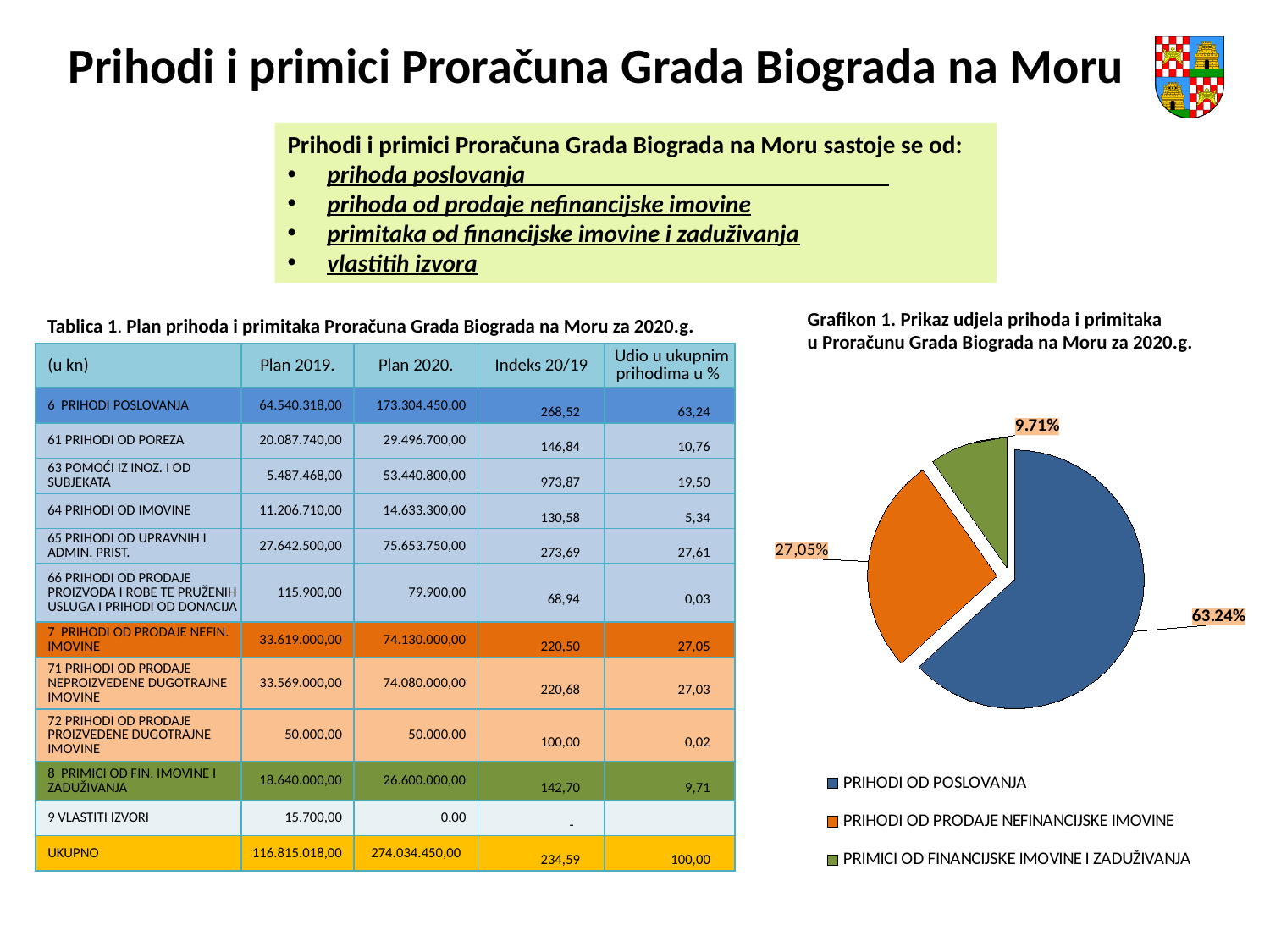
In the pie chart, what share is shown for PRIHODI OD PRODAJE NEFINANCIJSKE IMOVINE? 27,05% What type of chart is Grafikon 1 on the slide? pie chart Which category has the smallest slice in the pie chart? PRIMICI OD FINANCIJSKE IMOVINE I ZADUŽIVANJA In the pie chart, what share is shown for PRIHODI OD POSLOVANJA? 63.24% In the pie chart, which is larger: the slice for PRIHODI OD PRODAJE NEFINANCIJSKE IMOVINE or the slice for PRIMICI OD FINANCIJSKE IMOVINE I ZADUŽIVANJA? PRIHODI OD PRODAJE NEFINANCIJSKE IMOVINE What is the title of the pie chart on the slide? Grafikon 1. Prikaz udjela prihoda i primitaka u Proračunu Grada Biograda na Moru za 2020.g. How many entries does the legend of the pie chart list? 3 In the pie chart, what colour is the slice for PRIHODI OD POSLOVANJA? blue How many slices does the pie chart have? 3 Which category has the largest slice in the pie chart? PRIHODI OD POSLOVANJA In the pie chart, what share is shown for PRIMICI OD FINANCIJSKE IMOVINE I ZADUŽIVANJA? 9.71%